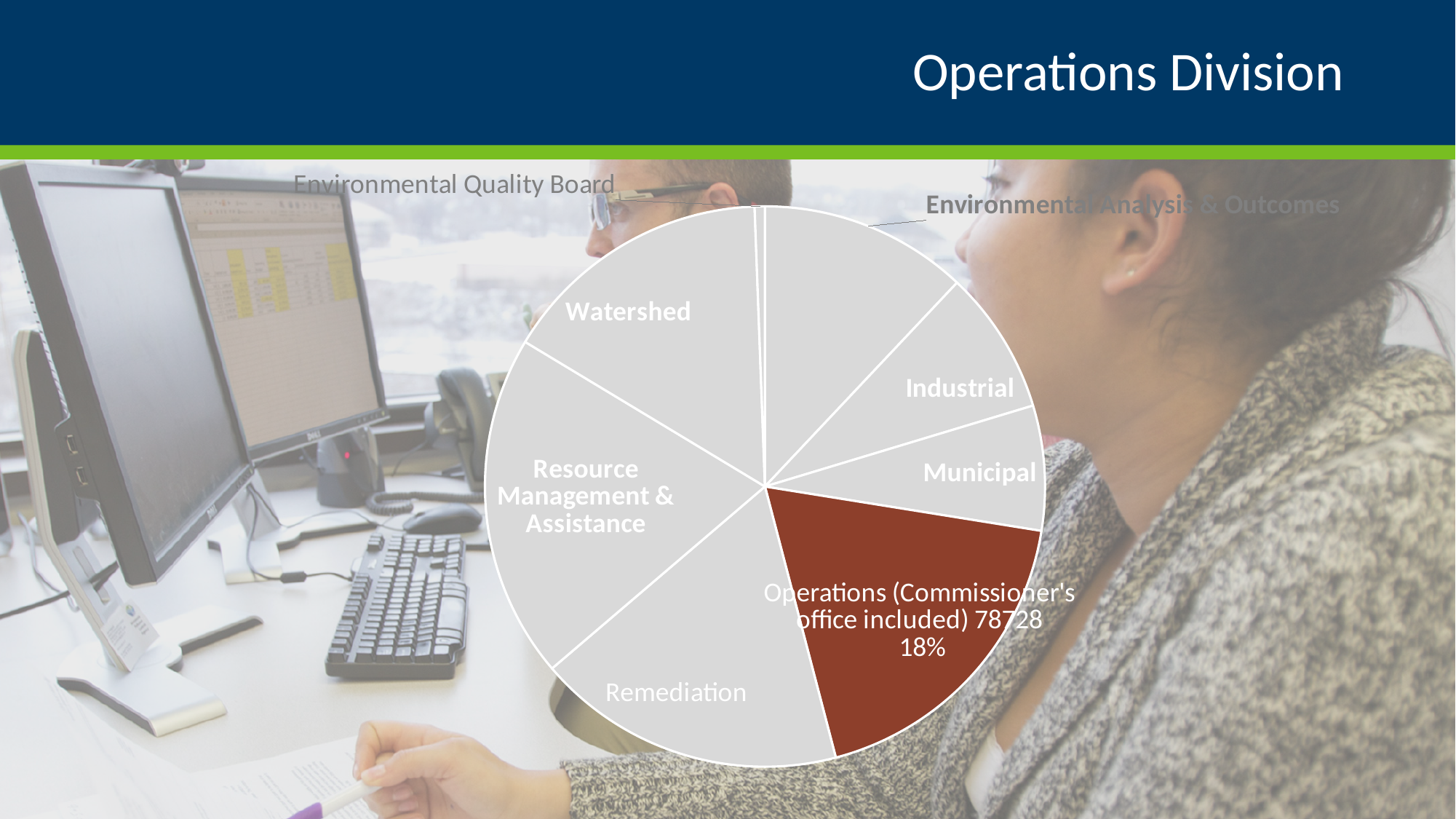
Which slice is larger, Resource Management & Assistance or Environmental Quality Board? Resource Management & Assistance What is the title of the slide containing the pie chart? Operations Division Which slice is larger, Watershed or Municipal? Watershed Which slice of the pie chart is the smallest? Environmental Quality Board What kind of chart is shown on the slide? pie chart Which slice of the pie chart is highlighted in a dark red colour? Operations (Commissioner's office included) What value is printed for the Operations (Commissioner's office included) slice? 78728 How many slices does the pie chart have? 8 Which slice is larger, Operations (Commissioner's office included) or Industrial? Operations (Commissioner's office included) What share of the pie does the Operations (Commissioner's office included) slice represent? 18%